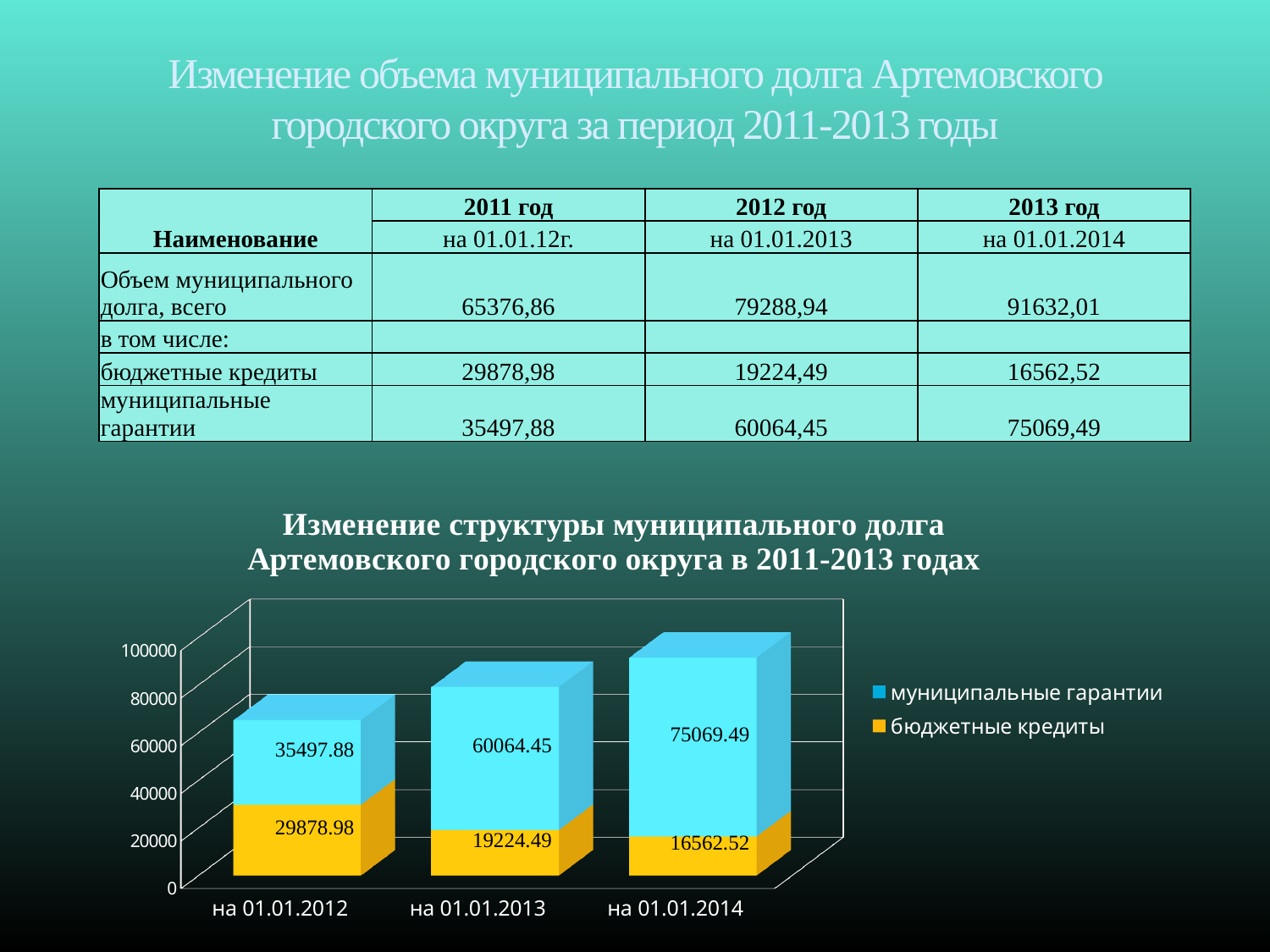
What is the value of бюджетные кредиты for на 01.01.2014? 16562.52 What is the value of муниципальные гарантии for на 01.01.2013? 60064.45 Do the values for бюджетные кредиты rise or fall from на 01.01.2012 to на 01.01.2014? Fall Which is larger: бюджетные кредиты for на 01.01.2013 or муниципальные гарантии for на 01.01.2013? муниципальные гарантии Which category has the lowest value for муниципальные гарантии? на 01.01.2012 What is the value of муниципальные гарантии for на 01.01.2012? 35497.88 How many categories are shown on the x axis of the chart? 3 Which category has the highest value for бюджетные кредиты? на 01.01.2012 How many series does the chart legend list? 2 What type of chart is shown on the slide? Stacked bar chart What is the difference between муниципальные гарантии for на 01.01.2014 and for на 01.01.2012? 39571.61 What is the total of the stacked bar for на 01.01.2013? 79288.94